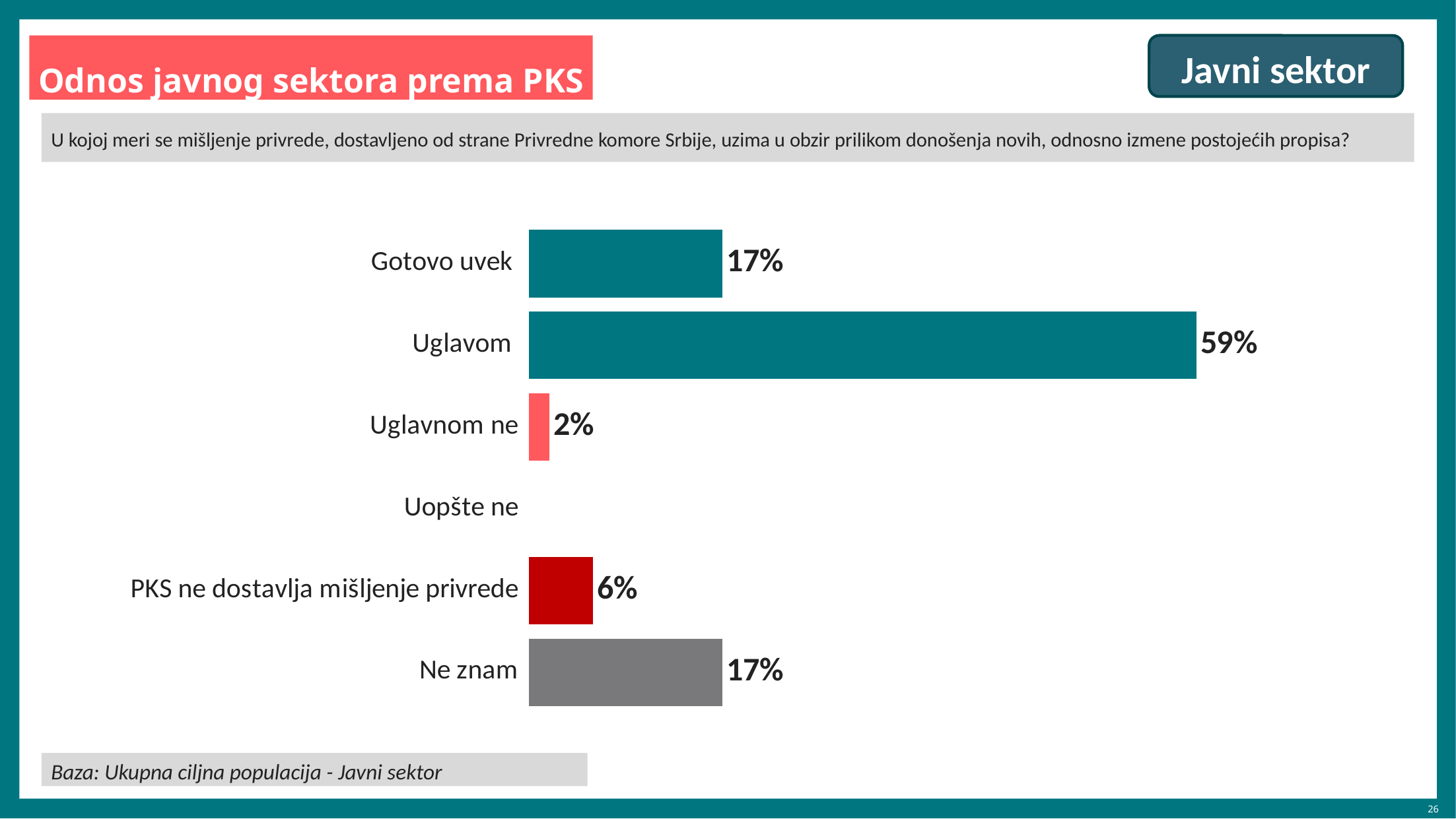
What percentage is shown for "Uglavom"? 59% What percentage is shown for "PKS ne dostavlja mišljenje privrede"? 6% What percentage is shown for "Uglavnom ne"? 2% What is the difference between the values for "Uglavom" and "Gotovo uvek"? 42% How many categories are listed on the chart? 6 What percentage is shown for "Ne znam"? 17% Which is larger, the value for "PKS ne dostavlja mišljenje privrede" or the value for "Uglavnom ne"? PKS ne dostavlja mišljenje privrede What percentage is shown for "Gotovo uvek"? 17% What kind of chart is shown on the slide? Bar chart Which category has the highest value? Uglavom Which category on the chart has no bar displayed? Uopšte ne What is the difference between the values for "Ne znam" and "PKS ne dostavlja mišljenje privrede"? 11%